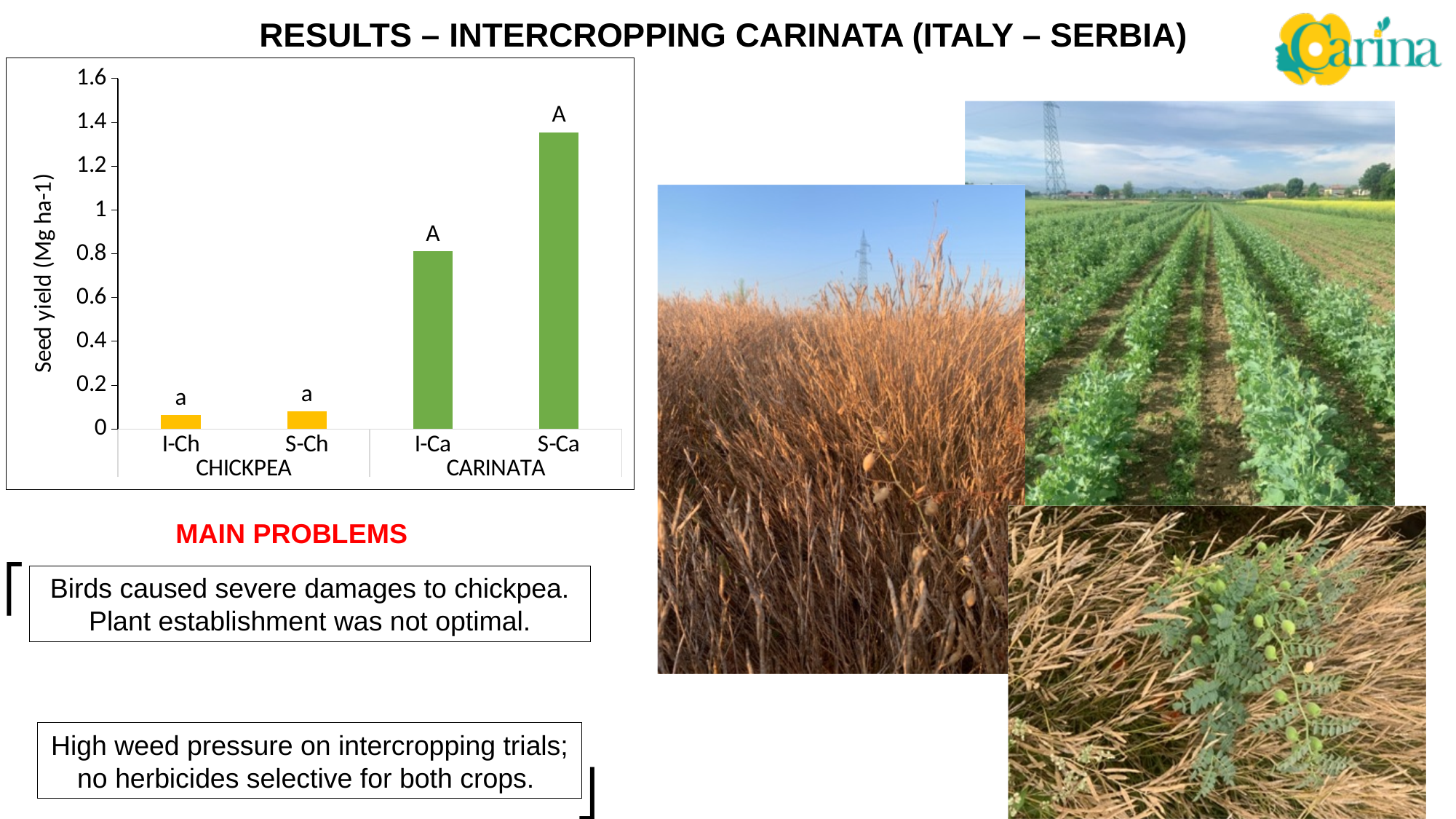
What are the two crop groups labelled along the x axis of the chart? CHICKPEA and CARINATA Which has a higher seed yield, I-Ca or S-Ca? S-Ca How many bars are plotted in the chart? 4 Is the seed yield for I-Ca greater or less than 0.6 Mg ha-1? greater Which treatment has the lowest seed yield in the chart? I-Ch Which has a higher seed yield, S-Ch or I-Ca? I-Ca Is the seed yield for I-Ca greater or less than 1 Mg ha-1? less Is the seed yield for I-Ch greater or less than 0.2 Mg ha-1? less What is the label of the vertical axis of the chart? Seed yield (Mg ha-1) What kind of chart is shown on the slide? bar chart Which treatment has the highest seed yield in the chart? S-Ca